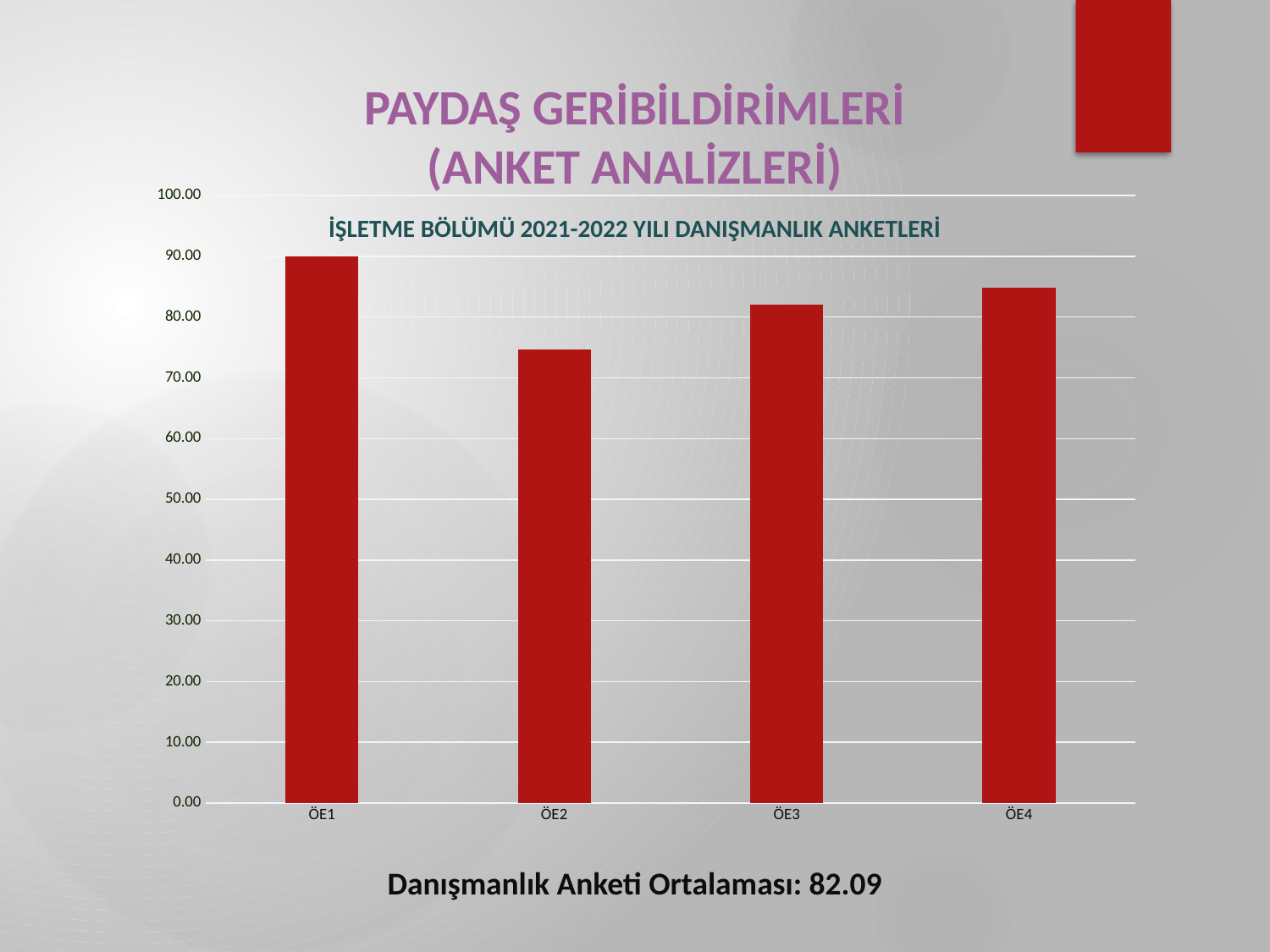
Which category has the lowest bar in the chart? ÖE2 Is the value for ÖE3 greater or less than 80? greater What kind of chart is shown on the slide? bar chart Is the value for ÖE1 greater or less than 80? greater Is the value for ÖE4 greater or less than 90? less How many categories are plotted on the x axis of the chart? 4 Which is larger, the value for ÖE3 or the value for ÖE4? ÖE4 Which is larger, the value for ÖE1 or the value for ÖE2? ÖE1 Which category has the highest bar in the chart? ÖE1 What colour are the bars in the chart? red What is the title of the chart? İŞLETME BÖLÜMÜ 2021-2022 YILI DANIŞMANLIK ANKETLERİ